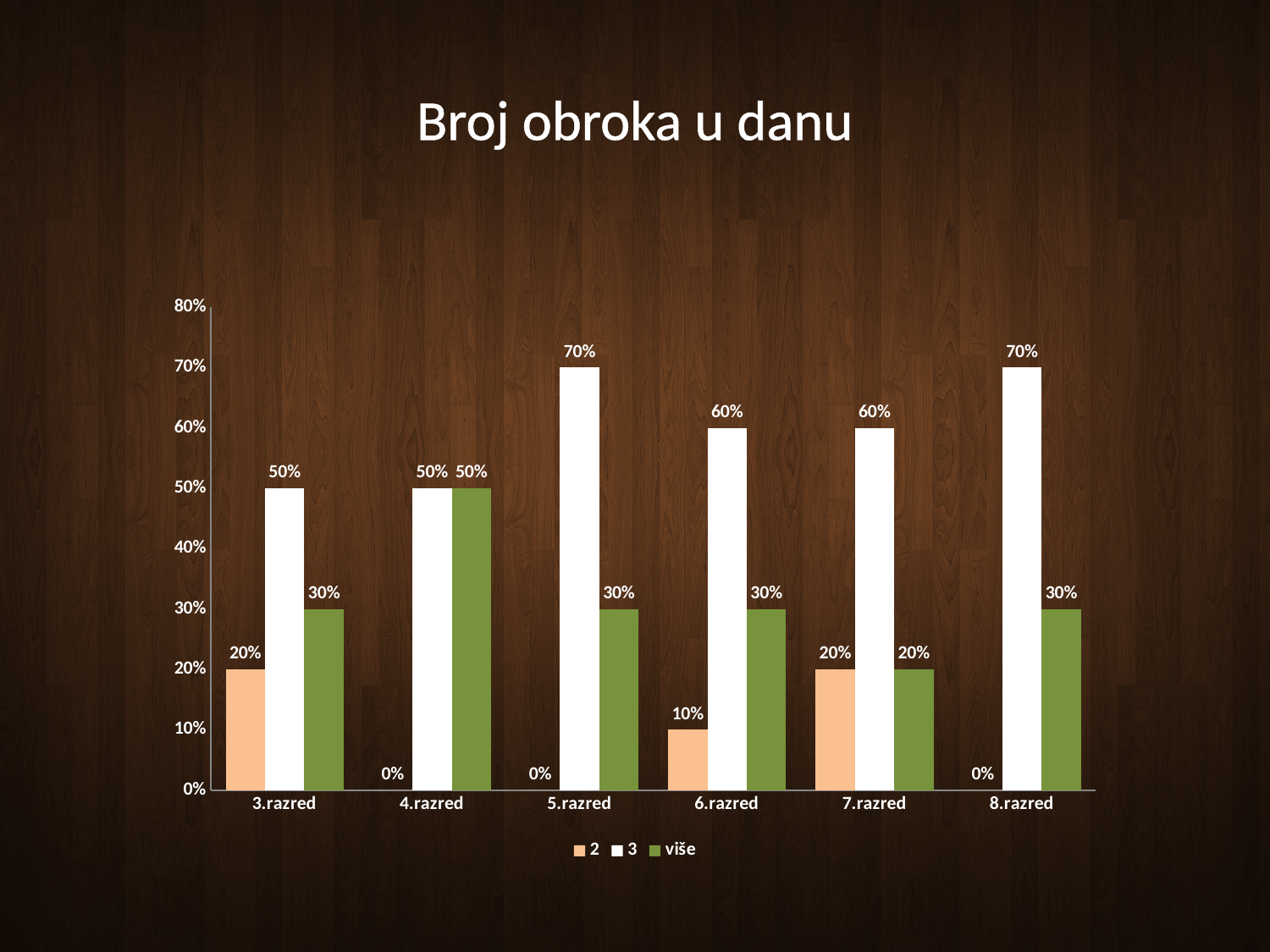
What is the difference between the "3" value and the "više" value in 5.razred? 40% Which category has the highest value for series "više"? 4.razred What is the value for series "3" in 5.razred? 70% Which category has the lowest value for series "3"? 3.razred and 4.razred What is the value for series "2" in 8.razred? 0% Which is larger in 7.razred: the value for "3" or the value for "više"? 3 What is the value for series "2" in 6.razred? 10% How many categories are shown on the x axis? 6 What kind of chart is shown on the slide? Bar chart What is the value for series "više" in 4.razred? 50% How many series does the legend list? 3 What is the title of the chart? Broj obroka u danu